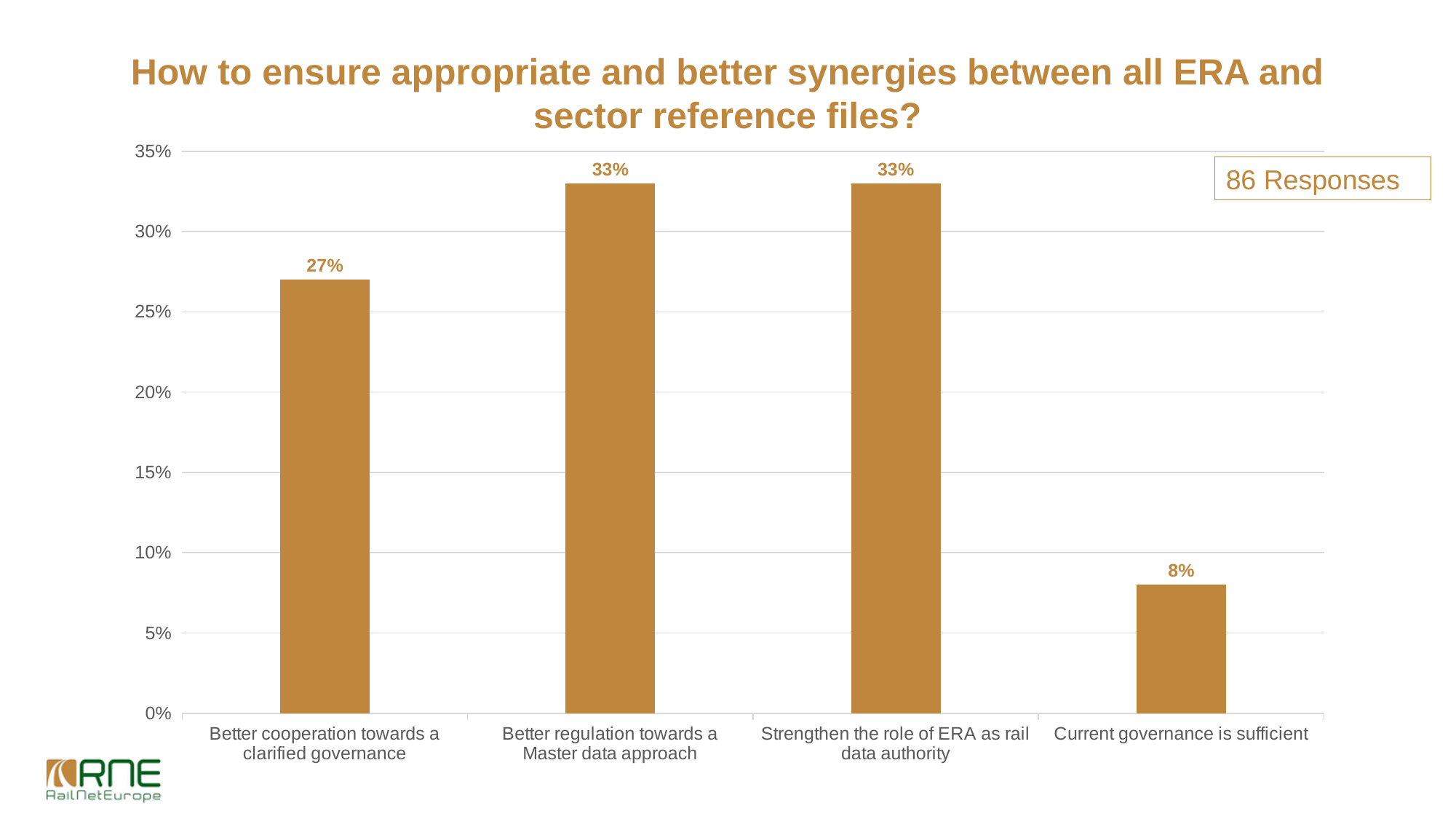
What is the value for "Strengthen the role of ERA as rail data authority"? 33% What is the value for "Current governance is sufficient"? 8% What is the value for "Better regulation towards a Master data approach"? 33% What is the difference between the values for "Better cooperation towards a clarified governance" and "Current governance is sufficient"? 19% Is the value for "Better cooperation towards a clarified governance" greater or less than 25%? greater What kind of chart is shown on the slide? Bar chart How many categories are shown on the chart? 4 What is the value for "Better cooperation towards a clarified governance"? 27% Which category has the lowest value? Current governance is sufficient What is the difference between the values for "Better regulation towards a Master data approach" and "Better cooperation towards a clarified governance"? 6% Which is larger, the value for "Better cooperation towards a clarified governance" or the value for "Current governance is sufficient"? Better cooperation towards a clarified governance How many responses does the chart report? 86 Responses